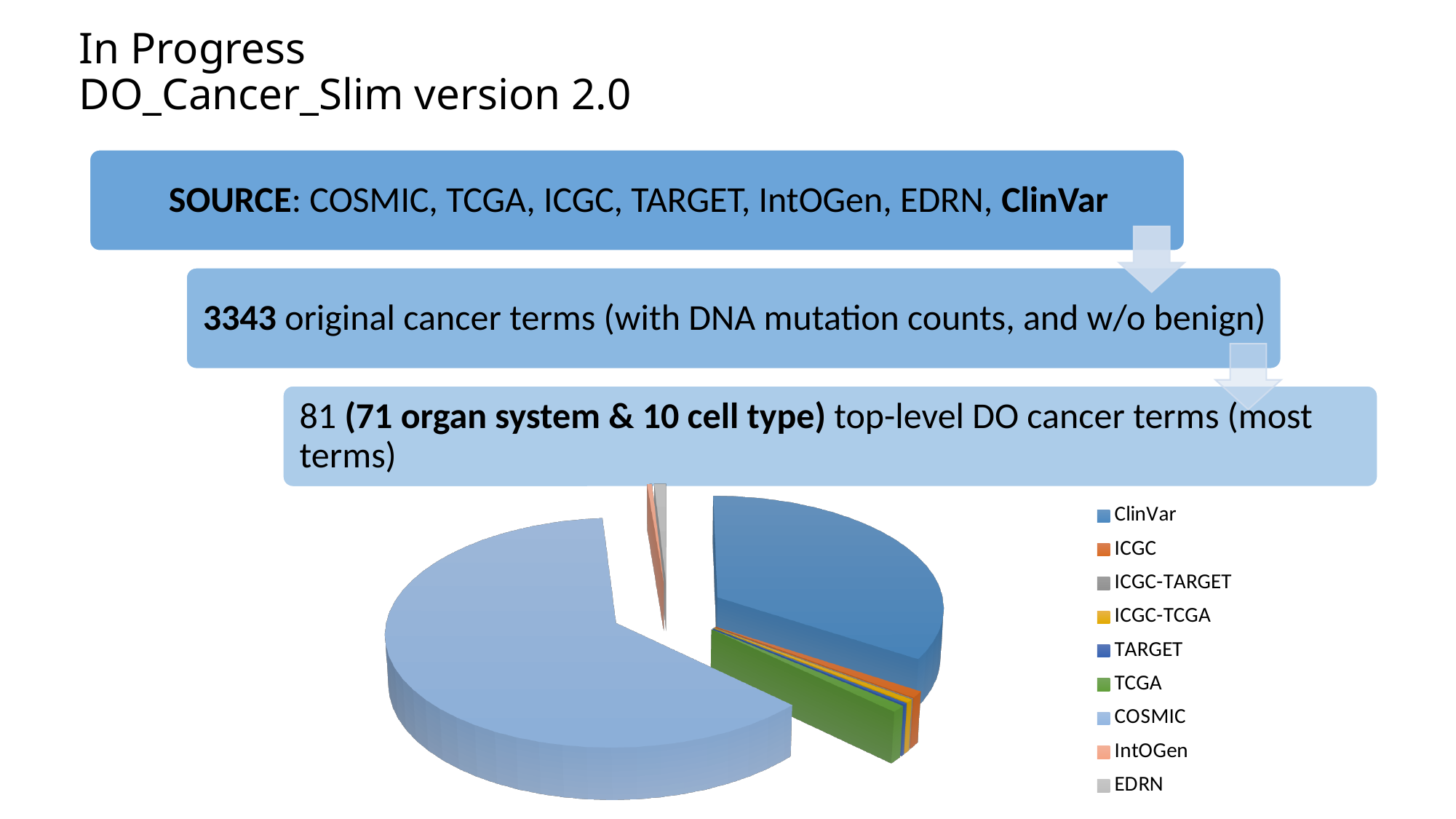
Which slice is larger in the pie chart, ClinVar or TCGA? ClinVar What kind of chart is shown on the slide? Pie chart What colour is the TCGA slice in the pie chart? Green How many categories does the pie chart's legend list? 9 Which category is the second-largest slice in the pie chart? ClinVar Which category has the largest slice in the pie chart? COSMIC Which category is listed first in the pie chart's legend? ClinVar Which slice is larger in the pie chart, ClinVar or ICGC? ClinVar Which slice is larger in the pie chart, COSMIC or ClinVar? COSMIC